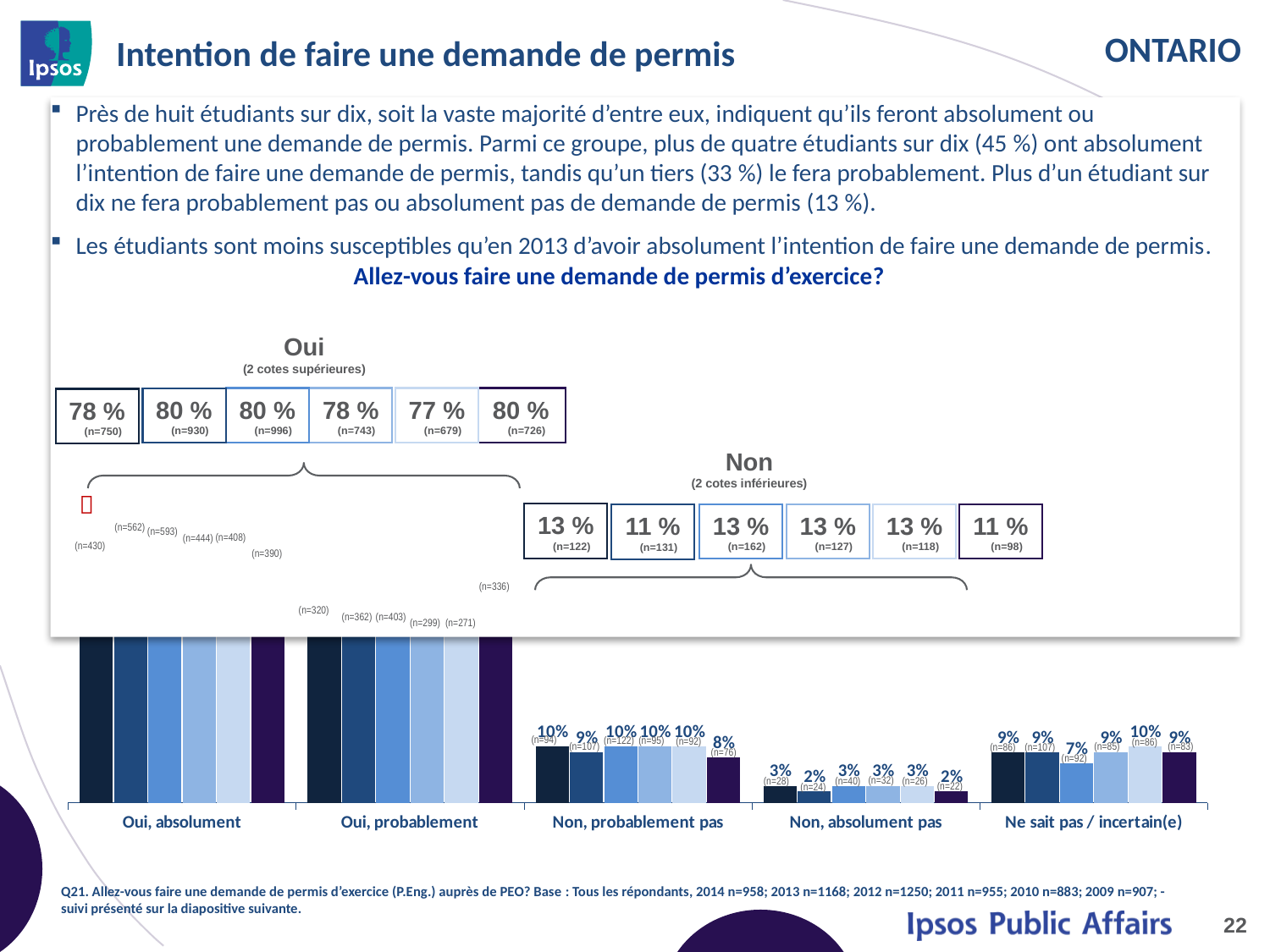
What is the value of the first bar in the 'Non, absolument pas' group? 3% What is the value of the last bar in the 'Non, probablement pas' group? 8% What is the difference between the first bar (10%) and the last bar (8%) in the 'Non, probablement pas' group? 2 percentage points What is the question title shown above the chart? Allez-vous faire une demande de permis d'exercice? In the 'Oui (2 cotes supérieures)' summary boxes, what is the value in the first box? 78 % Which response category has the shortest bars in the chart? Non, absolument pas How many bars are plotted for each response category in the chart? 6 In the 'Non (2 cotes inférieures)' summary boxes, what is the value in the last box? 11 % What kind of chart is shown on the slide? Bar chart What is the lowest labelled value in the 'Ne sait pas / incertain(e)' group? 7% How many response categories are shown along the x axis of the chart? 5 Which response category has the tallest bars in the chart? Oui, absolument